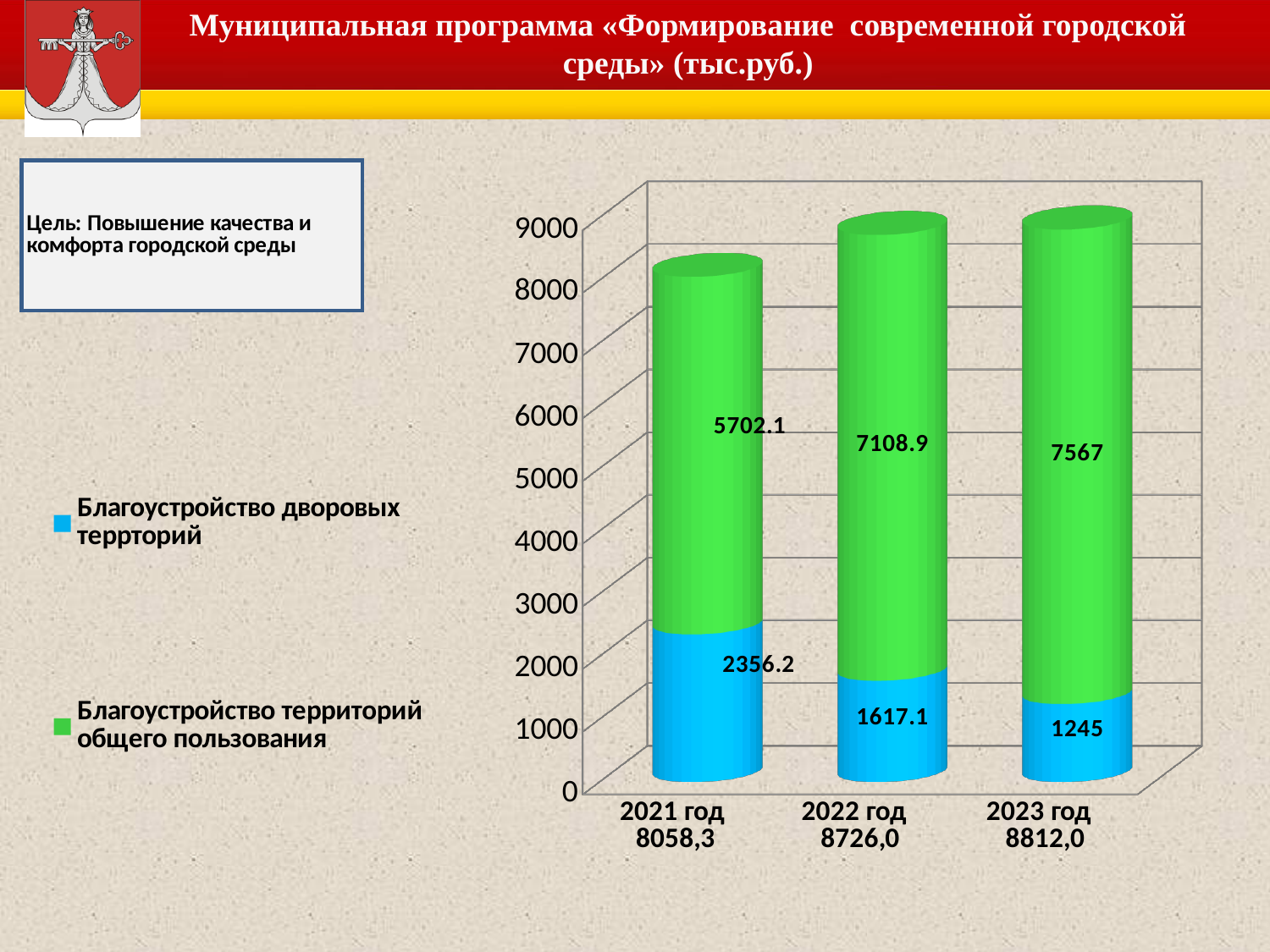
What is the value for Благоустройство дворовых терpторий in 2022 год? 1617.1 In which year is the value for Благоустройство дворовых терpторий lowest? 2023 год What is the total of the stacked bar for 2022 год? 8726,0 What is the difference between the Благоустройство территорий общего пользования values for 2023 год and 2022 год? 458.1 How many series does the legend list? 2 What kind of chart is shown on the slide? Stacked bar chart What is the value for Благоустройство дворовых терpторий in 2023 год? 1245 Which is larger: Благоустройство дворовых терpторий in 2021 год or in 2022 год? 2021 год Does the value for Благоустройство дворовых терpторий rise or fall from 2021 год to 2023 год? Fall What is the value for Благоустройство территорий общего пользования in 2021 год? 5702.1 How many years are shown on the x axis? 3 In which year is the value for Благоустройство территорий общего пользования highest? 2023 год